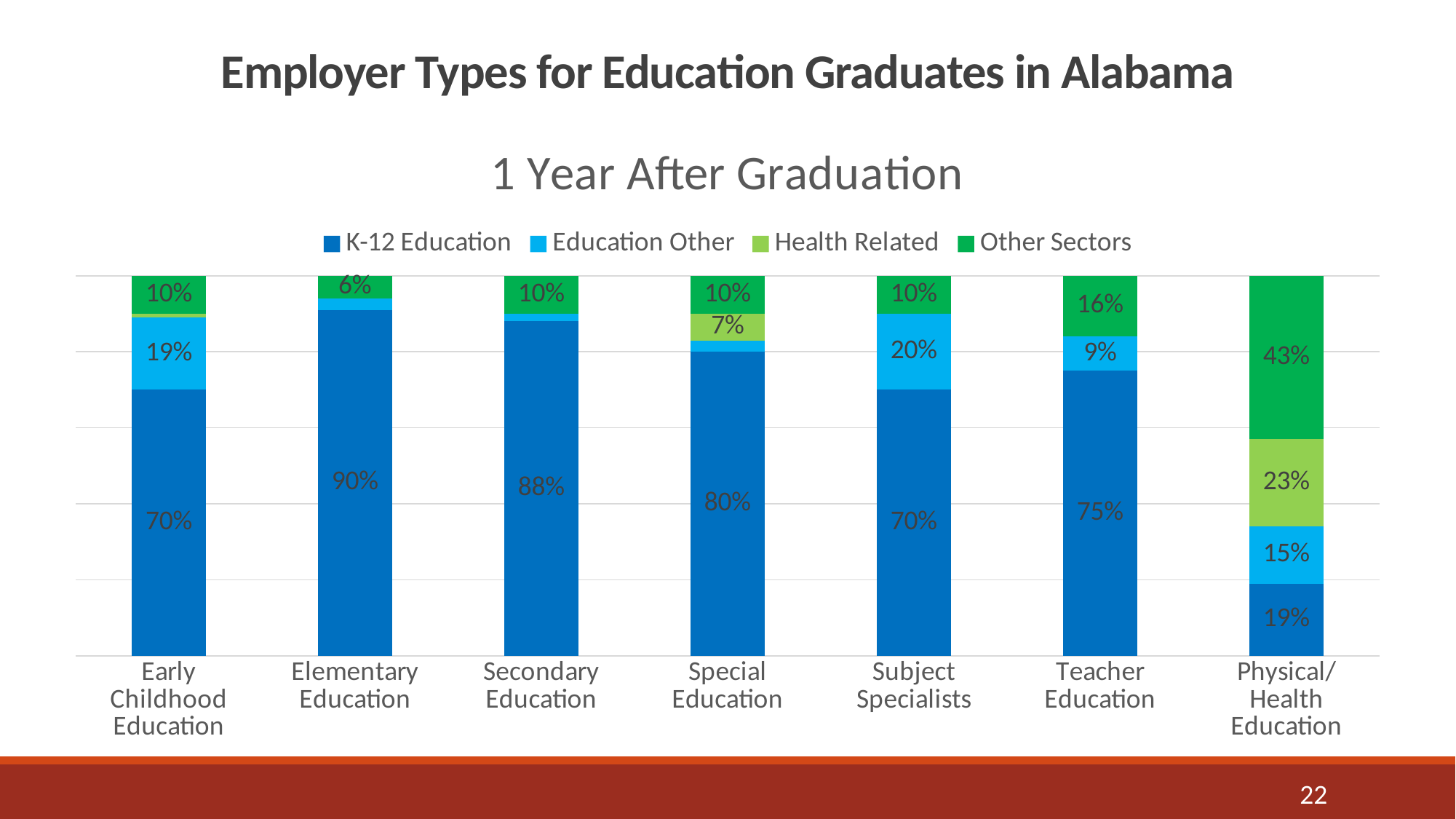
What is the K-12 Education value for Elementary Education? 90% What is the subtitle shown above the legend? 1 Year After Graduation What is the difference between the K-12 Education values for Secondary Education and Teacher Education? 13% What is the Other Sectors value for Physical/Health Education? 43% How many series does the legend list? 4 Which category has the highest K-12 Education value? Elementary Education How many categories are shown along the x axis? 7 What is the Education Other value for Subject Specialists? 20% Which category has the lowest K-12 Education value? Physical/Health Education What kind of chart is shown on the slide? Stacked bar chart What is the Health Related value for Special Education? 7% Which is larger: the Other Sectors value for Teacher Education or for Early Childhood Education? Teacher Education